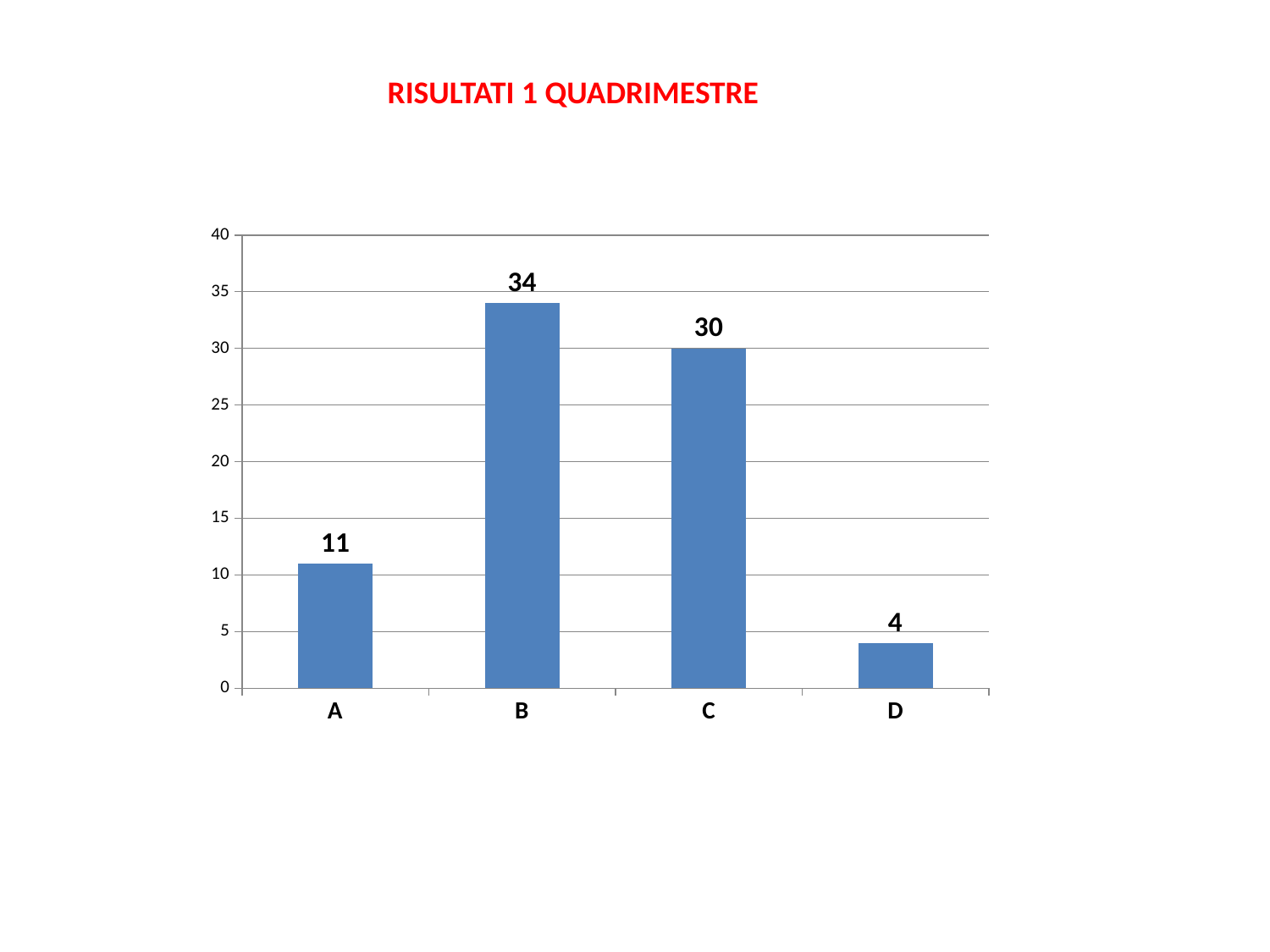
What is the difference between the values for B and C? 4 Is the value for C greater or less than 25? greater Which category has the lowest value? D What is the value for category D? 4 What is the title of the slide above the chart? RISULTATI 1 QUADRIMESTRE What is the value for category A? 11 What kind of chart is shown on the slide? bar chart How many categories are shown on the x axis? 4 Which category has the highest value? B What is the difference between the values for A and D? 7 What is the value for category B? 34 Which is larger, the value for A or the value for C? C